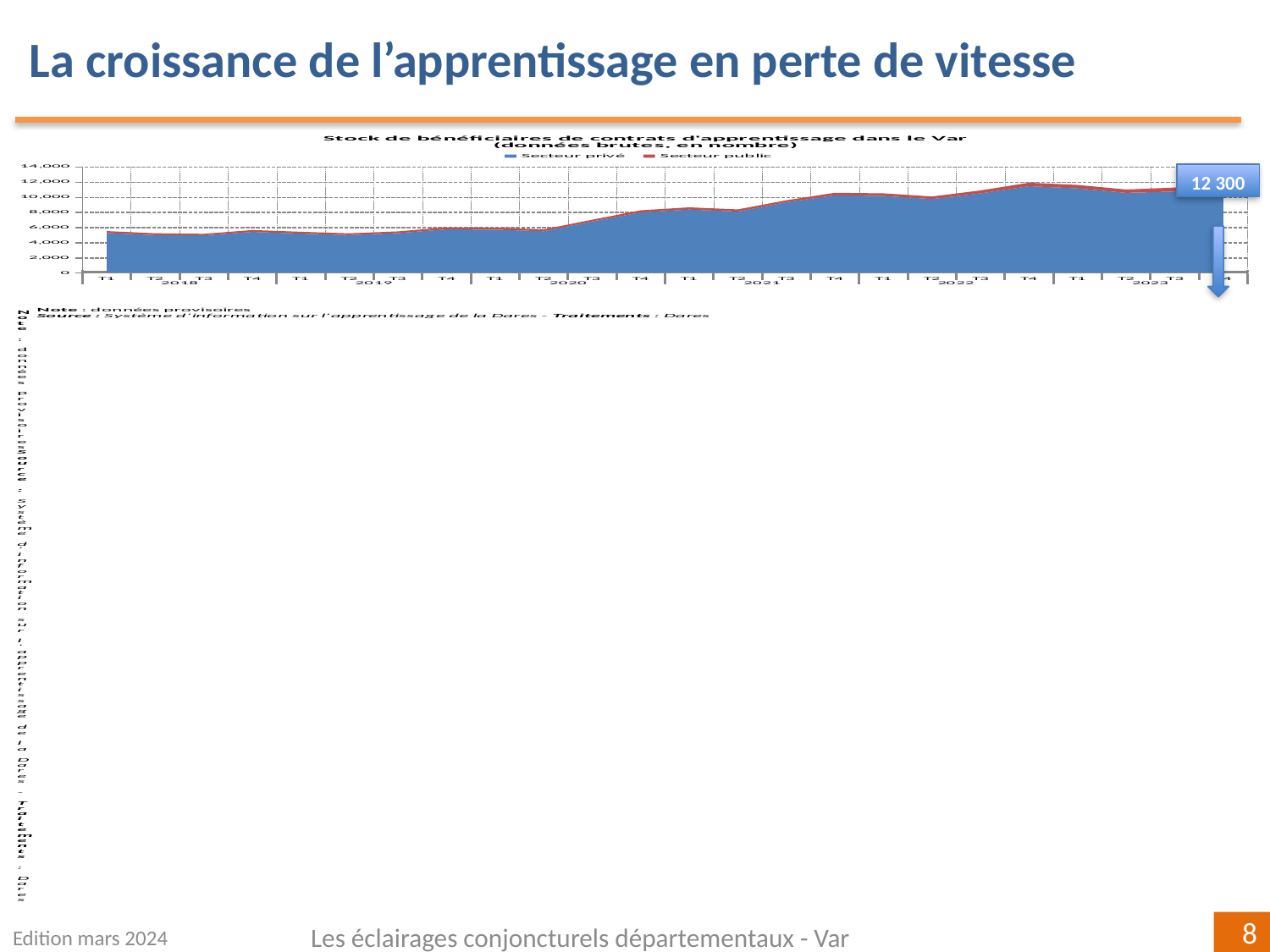
What value is printed in the callout box at the right end of the chart? 12 300 Is the total value for T1 2018 greater or less than 6,000? less Overall, do the values rise or fall from 2018 to 2023 along the x axis? Rise Is the total value for T4 2022 greater or less than 10,000? greater Which series is shown in blue in the chart? Secteur privé How many series does the chart legend list? 2 Which quarter has the larger total value, T1 2018 or T4 2022? T4 2022 What are the two series named in the chart legend? Secteur privé and Secteur public What kind of chart is shown on the slide? Area chart Is the total value for T4 2023 greater or less than 8,000? greater How many years are labelled along the x axis of the chart? 6